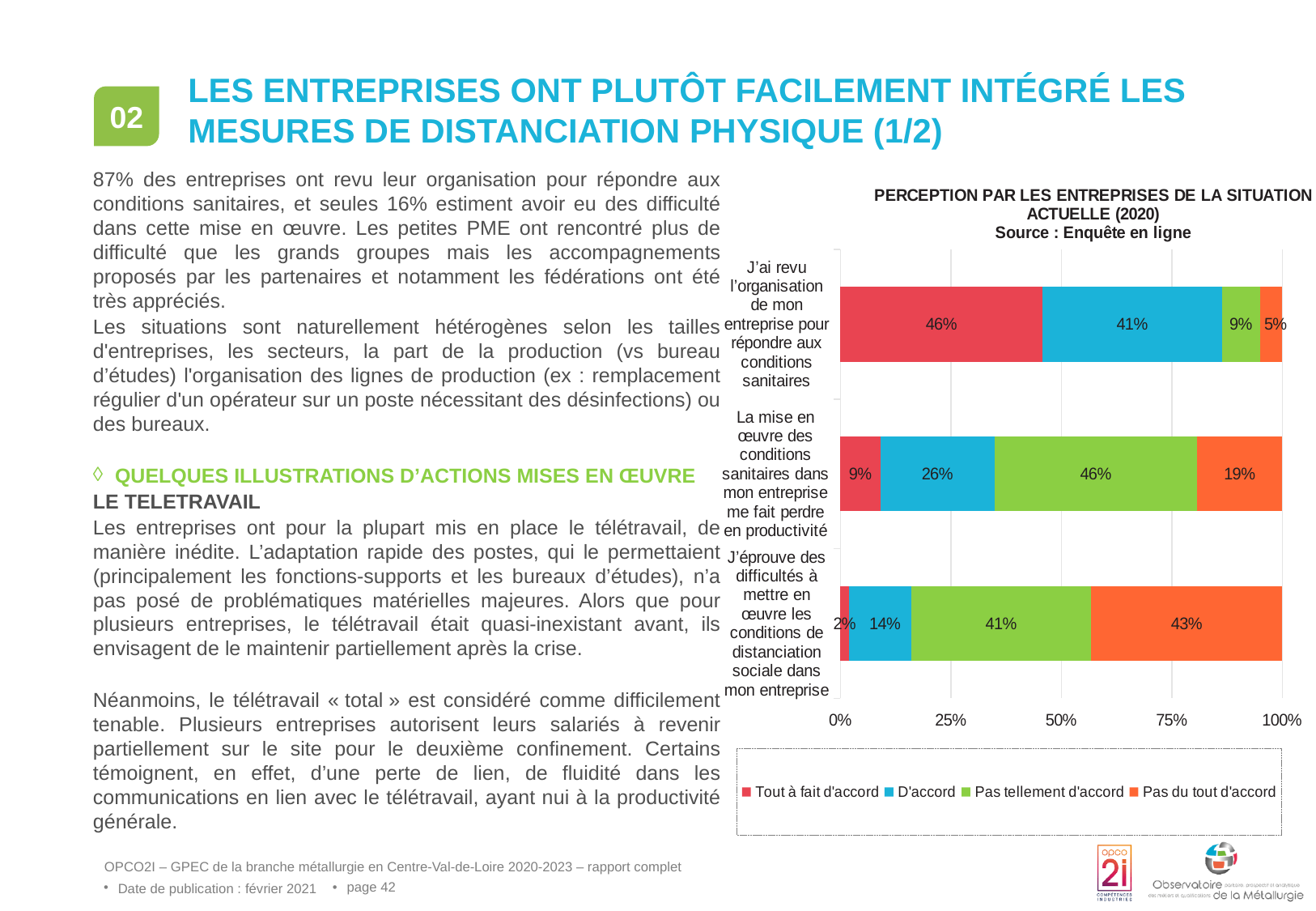
What is the source given under the chart title? Enquête en ligne How many statements (categories) are plotted in the chart? 3 What is the difference between the "Pas tellement d'accord" share for "La mise en œuvre des conditions sanitaires ... me fait perdre en productivité" and for "J'ai revu l'organisation de mon entreprise ..."? 37% How many series does the chart legend list? 4 What share of companies answered "D'accord" to "La mise en œuvre des conditions sanitaires dans mon entreprise me fait perdre en productivité"? 26% For which statement is the "Pas du tout d'accord" share the highest? J'éprouve des difficultés à mettre en œuvre les conditions de distanciation sociale dans mon entreprise What share of companies answered "Pas du tout d'accord" to "J'éprouve des difficultés à mettre en œuvre les conditions de distanciation sociale dans mon entreprise"? 43% Which is larger for "J'ai revu l'organisation de mon entreprise pour répondre aux conditions sanitaires": the "Tout à fait d'accord" share or the "D'accord" share? Tout à fait d'accord What is the combined share of "Tout à fait d'accord" and "D'accord" for "J'éprouve des difficultés à mettre en œuvre les conditions de distanciation sociale dans mon entreprise"? 16% For which statement is the "Tout à fait d'accord" share the lowest? J'éprouve des difficultés à mettre en œuvre les conditions de distanciation sociale dans mon entreprise What share of companies answered "Tout à fait d'accord" to "J'ai revu l'organisation de mon entreprise pour répondre aux conditions sanitaires"? 46% What kind of chart is shown on the slide? stacked bar chart